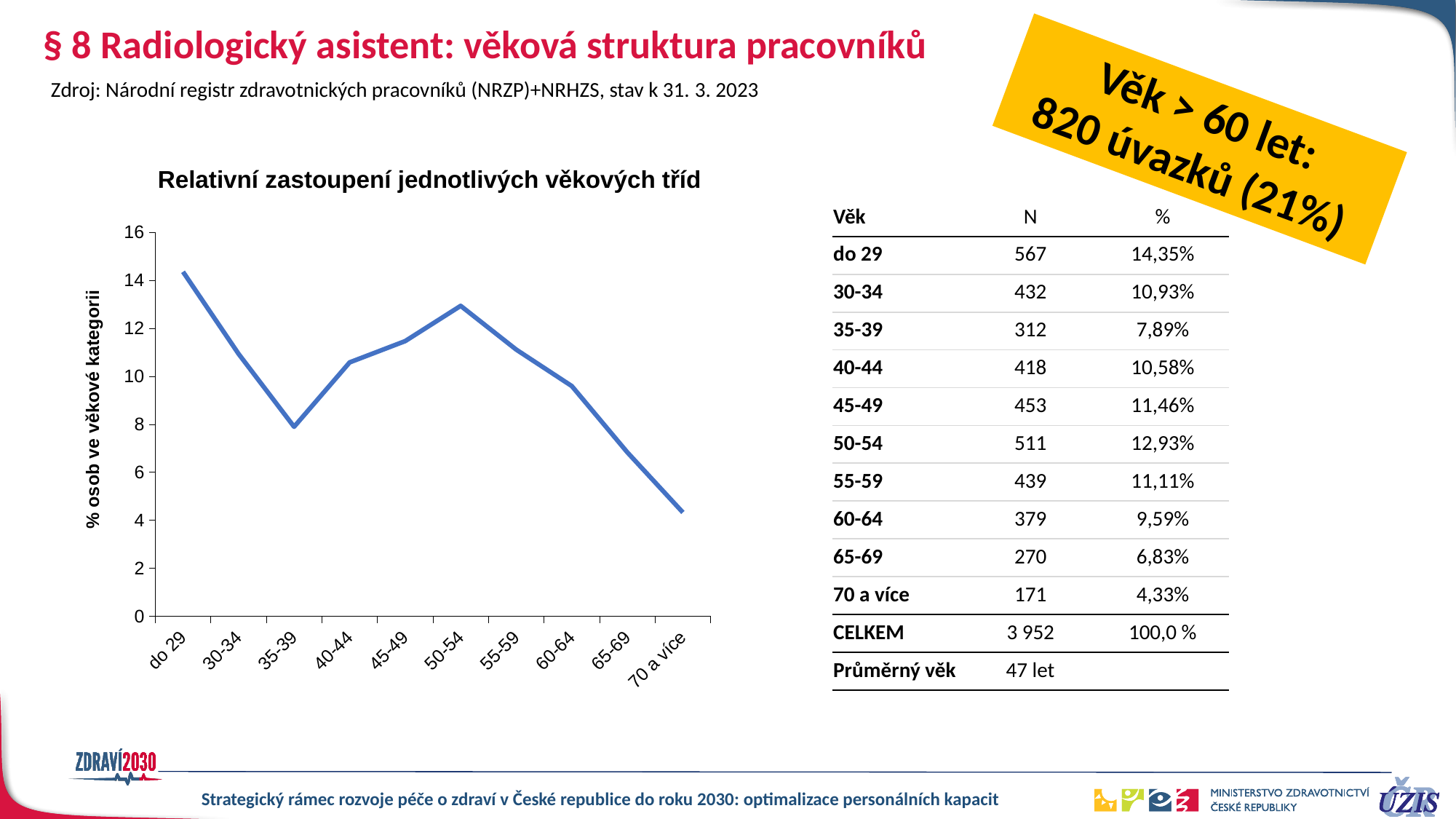
Do the values rise or fall along the x axis from 50-54 to 70 a více? fall What is the title of the chart? Relativní zastoupení jednotlivých věkových tříd Which age category has the highest value in the chart? do 29 How many age categories are plotted along the x axis of the chart? 10 Which is larger, the value for 45-49 or the value for 40-44? 45-49 Is the value for 50-54 greater or less than 12? greater Is the value for 35-39 greater or less than 10? less According to the table on the slide, what is the percentage for the 50-54 age category? 12,93% What is the label of the y axis of the chart? % osob ve věkové kategorii What kind of chart is shown on the slide? line chart Which age category has the lowest value in the chart? 70 a více Do the values rise or fall along the x axis from do 29 to 35-39? fall